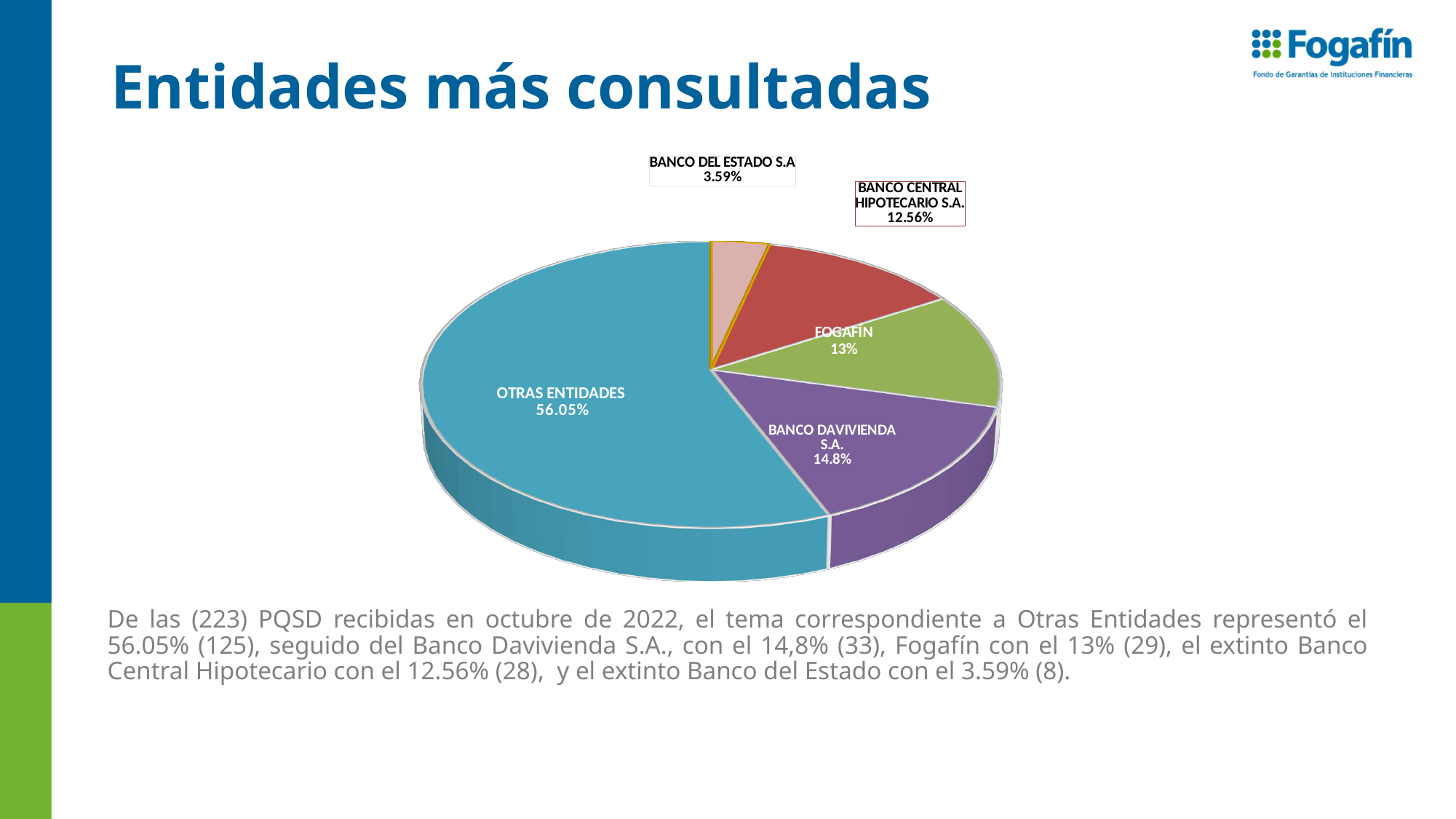
What is the value shown for FOGAFÍN? 13% How many categories are shown in the pie chart? 5 Which is larger, the share for FOGAFÍN or the share for BANCO CENTRAL HIPOTECARIO S.A.? FOGAFÍN Which category has the largest slice of the pie? OTRAS ENTIDADES What colour is the OTRAS ENTIDADES slice? Blue What is the difference between the shares of OTRAS ENTIDADES and BANCO DAVIVIENDA S.A.? 41.25% Which category has the smallest slice of the pie? BANCO DEL ESTADO S.A What is the value shown for BANCO DEL ESTADO S.A? 3.59% What kind of chart is shown on the slide? Pie chart What is the value shown for BANCO CENTRAL HIPOTECARIO S.A.? 12.56% What share of the pie does OTRAS ENTIDADES represent? 56.05% What is the value shown for BANCO DAVIVIENDA S.A.? 14.8%